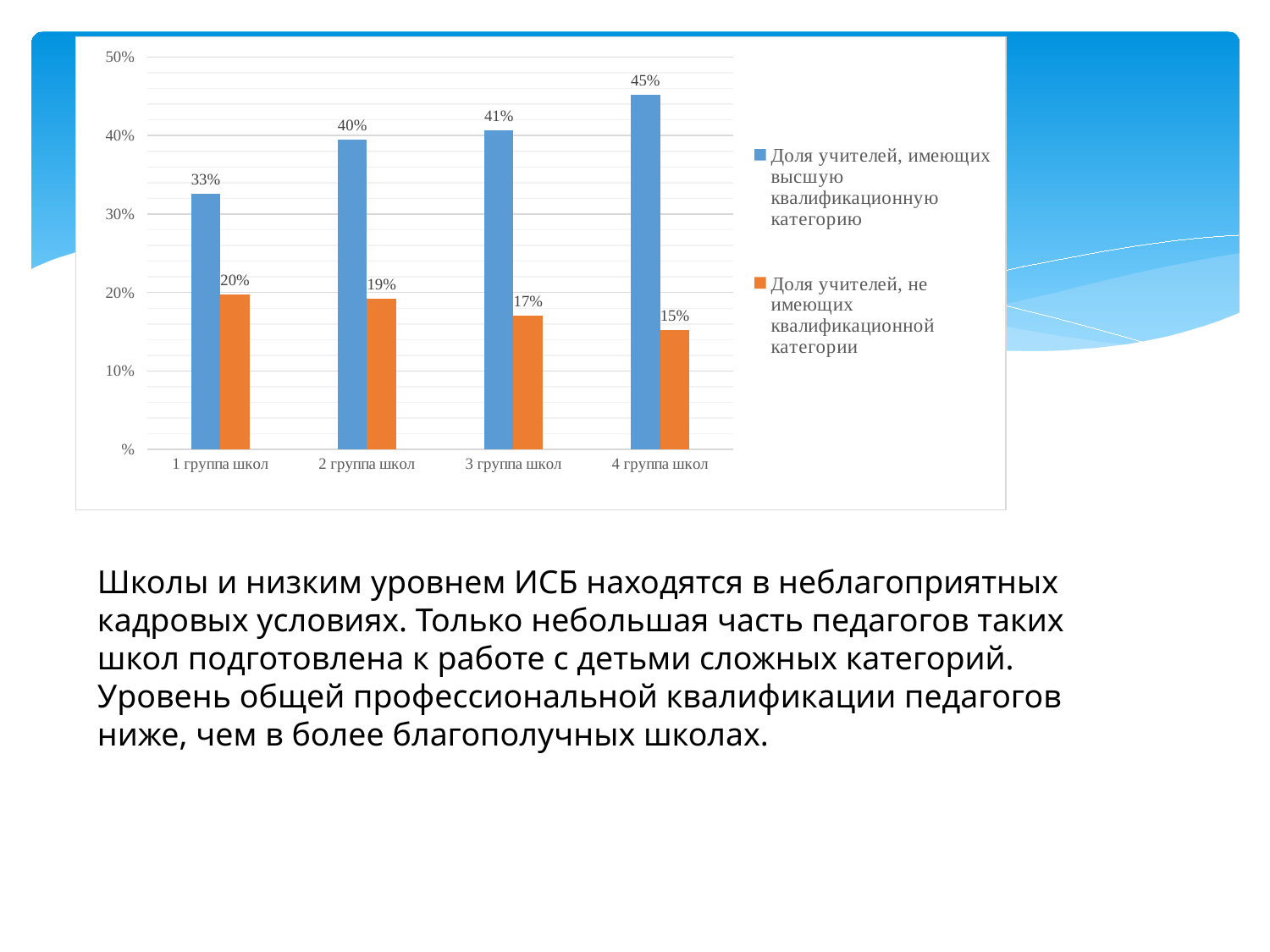
Does the share of teachers without a qualification category rise or fall from '1 группа школ' to '4 группа школ'? Fall Which is larger: the share of teachers without a qualification category in '1 группа школ' or in '3 группа школ'? 1 группа школ What is the difference between the share of teachers with the highest qualification category in '4 группа школ' and in '1 группа школ'? 12% Which school group has the lowest share of teachers without a qualification category? 4 группа школ What is the value for '3 группа школ' in the series 'Доля учителей, имеющих высшую квалификационную категорию'? 41% Which school group has the highest share of teachers with the highest qualification category? 4 группа школ What is the value for '4 группа школ' in the series 'Доля учителей, не имеющих квалификационной категории'? 15% What kind of chart is shown on the slide? Bar chart What is the value for '1 группа школ' in the series 'Доля учителей, имеющих высшую квалификационную категорию'? 33% How many series does the legend list? 2 What colour are the bars for the series 'Доля учителей, не имеющих квалификационной категории'? Orange How many school groups are shown on the x axis? 4